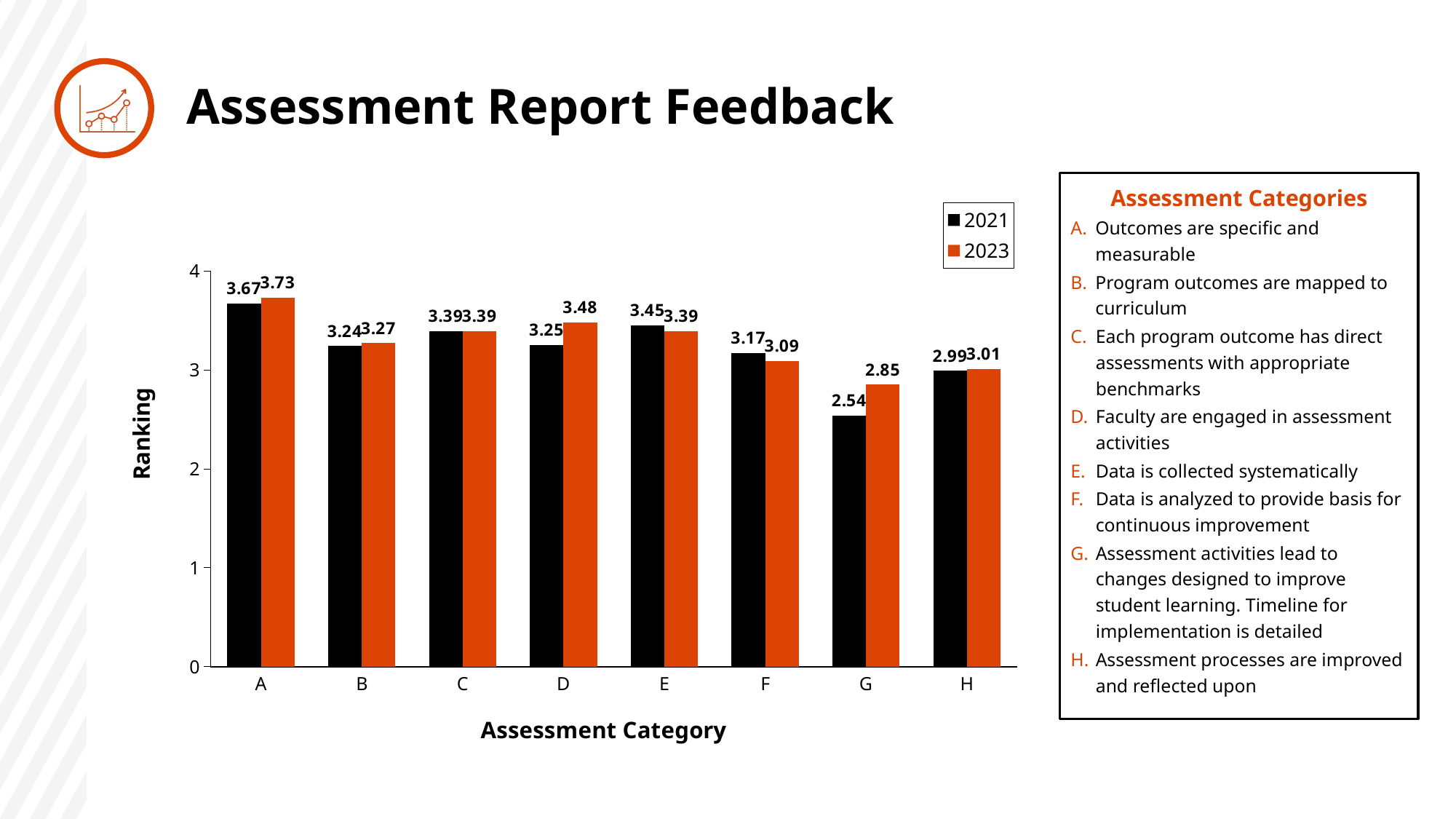
How many assessment categories are shown on the x axis? 8 For category E, which year has the higher ranking, 2021 or 2023? 2021 What is the 2023 ranking for assessment category D? 3.48 What is the label of the y axis? Ranking What kind of chart is shown on the slide? bar chart What is the 2023 ranking for assessment category G? 2.85 Which assessment category has the lowest 2021 ranking? G Is the 2021 ranking for category G greater or less than 3? less Which assessment category has the highest 2023 ranking? A What is the difference between the 2023 and 2021 rankings for category G? 0.31 What is the 2021 ranking for assessment category A? 3.67 How many series does the legend list? 2